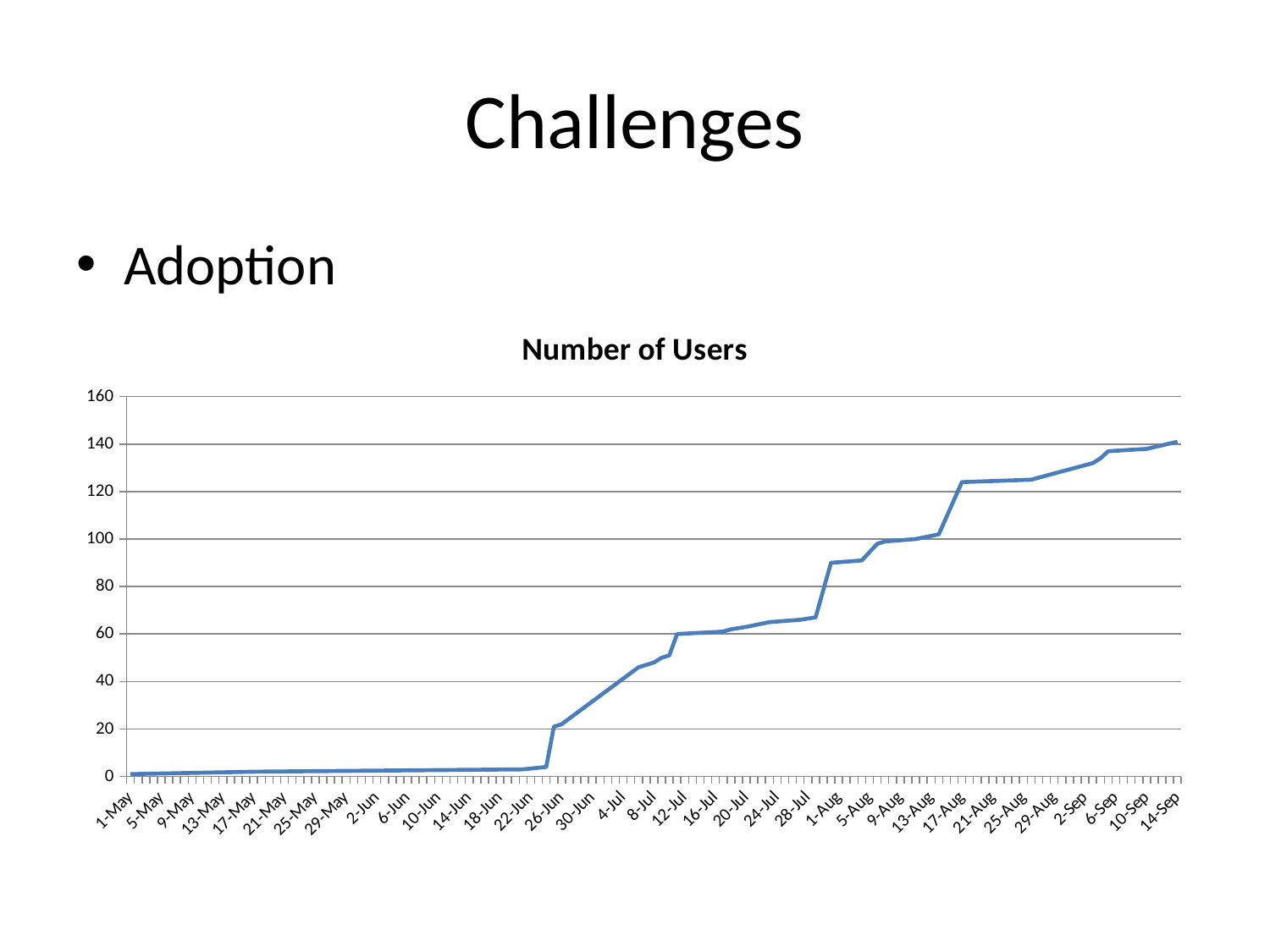
What is the title of the chart? Number of Users Is the value for 5-Aug greater or less than 100? less Do the values in the Number of Users chart rise or fall from 1-May to 14-Sep? rise Is the value for 14-Sep greater or less than 120? greater Which has the larger value, 4-Jul or 1-Aug? 1-Aug Is the value for 1-May greater or less than 20? less What is the highest value shown on the vertical axis? 160 What kind of chart is shown on the slide? line chart